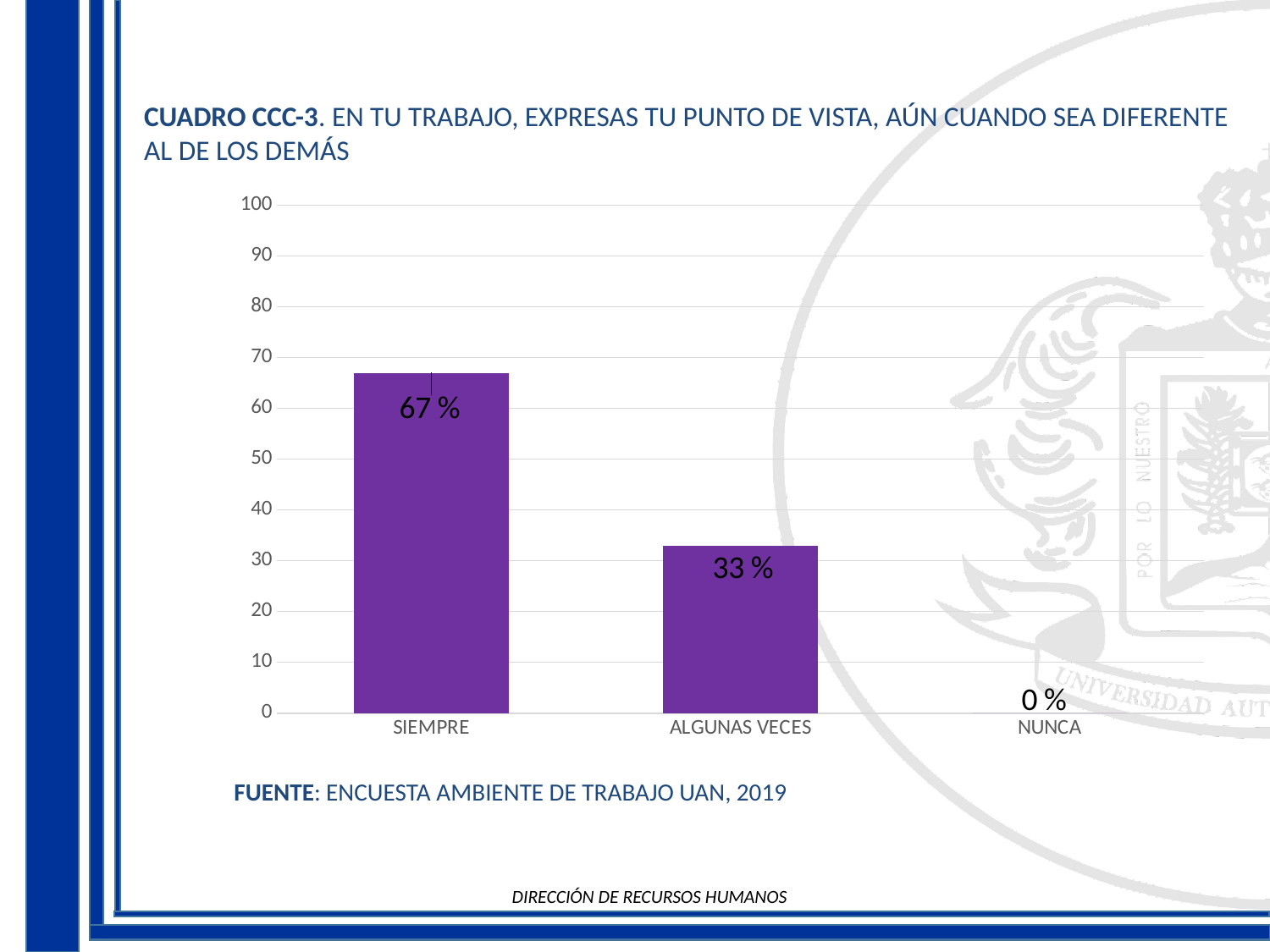
What is the difference between the values for SIEMPRE and ALGUNAS VECES? 34 % What kind of chart is shown on the slide? bar chart Which category has the highest value? SIEMPRE What is the value for NUNCA? 0 % Is the value for SIEMPRE greater or less than 60? greater What is the value for ALGUNAS VECES? 33 % Is the value for ALGUNAS VECES greater or less than 40? less What is the value for SIEMPRE? 67 % Which category has the lowest value? NUNCA Which is larger, the value for SIEMPRE or the value for ALGUNAS VECES? SIEMPRE How many categories are shown on the x axis? 3 What is the source cited below the chart? ENCUESTA AMBIENTE DE TRABAJO UAN, 2019